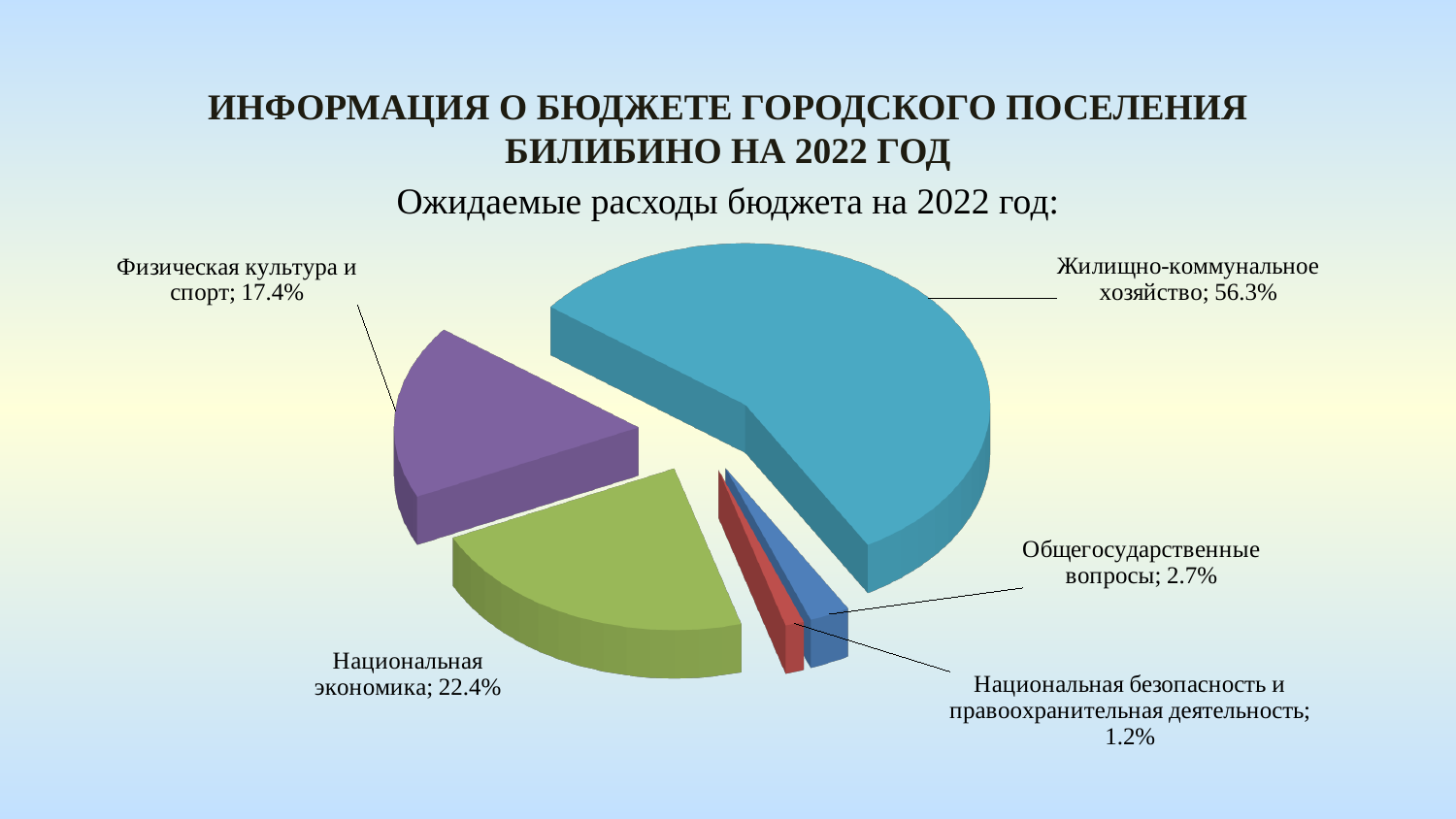
What percentage is shown for Национальная экономика? 22.4% Which category has the largest share of the expected 2022 budget expenditures? Жилищно-коммунальное хозяйство How many categories are shown in the pie chart? 5 What colour is the slice for Национальная экономика? Green Which is larger: the share for Национальная экономика or the share for Физическая культура и спорт? Национальная экономика What share of expected 2022 budget expenditures goes to Жилищно-коммунальное хозяйство? 56.3% Which category has the smallest share of the expected 2022 budget expenditures? Национальная безопасность и правоохранительная деятельность What type of chart is used on this slide? Pie chart What percentage is shown for Физическая культура и спорт? 17.4% What share is allocated to Общегосударственные вопросы? 2.7% What share is allocated to Национальная безопасность и правоохранительная деятельность? 1.2% What is the difference in percentage points between Жилищно-коммунальное хозяйство and Национальная экономика? 33.9